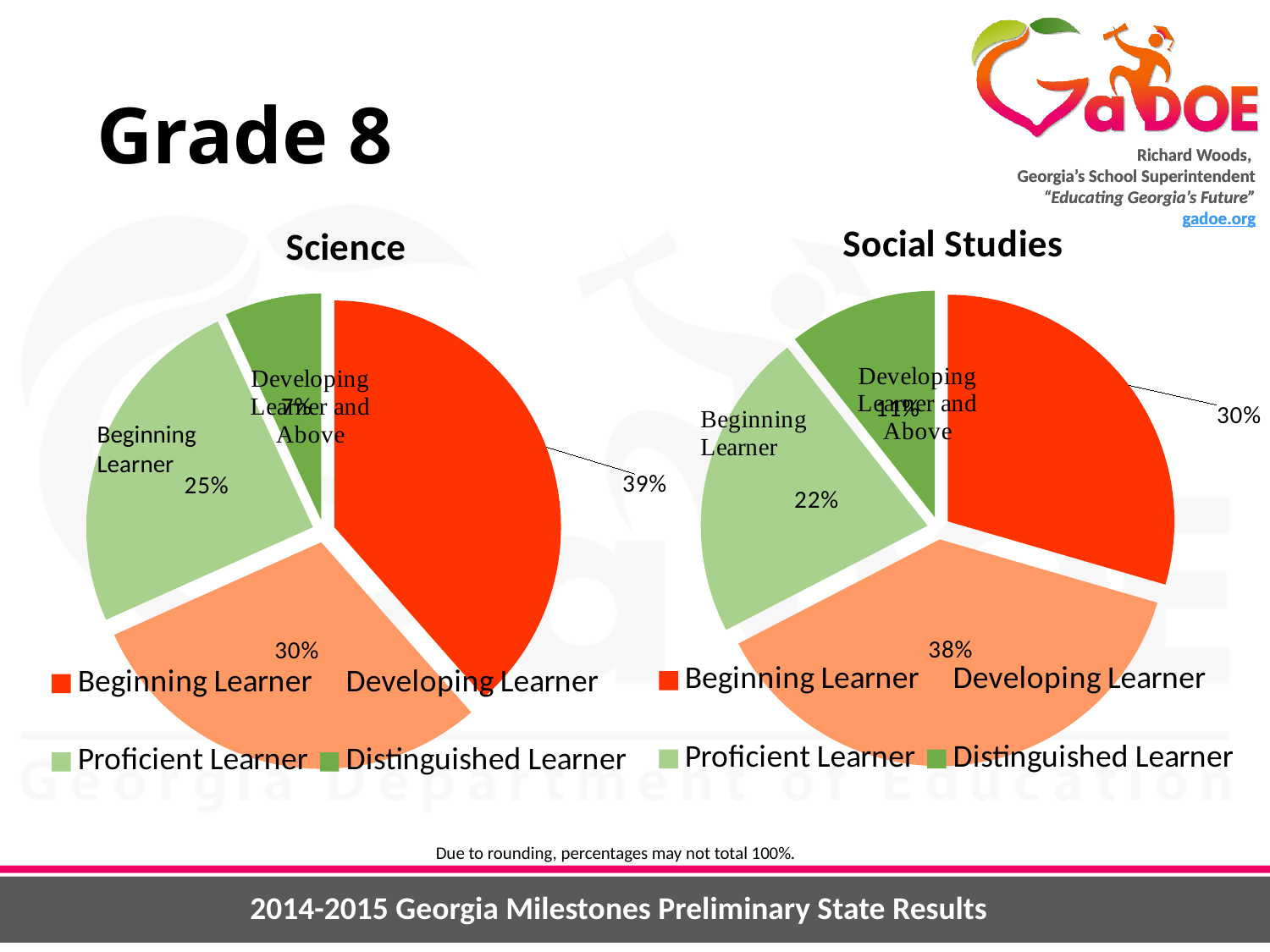
In the Science pie chart, which category has the largest share? Beginning Learner In the Science pie chart, what percentage is shown for Proficient Learner? 25% In the Science pie chart, what percentage is shown for Beginning Learner? 39% What type of chart is used for Science and Social Studies on this slide? Pie chart In the Social Studies pie chart, which category has the smallest share? Distinguished Learner In the Science pie chart, what percentage is shown for Developing Learner? 30% In the Social Studies pie chart, what percentage is shown for Distinguished Learner? 11% Which is larger in the Science pie chart: Proficient Learner or Developing Learner? Developing Learner In the Social Studies pie chart, what percentage is shown for Developing Learner? 38% In the Social Studies pie chart, what percentage is shown for Proficient Learner? 22% How many categories does the Social Studies pie chart show? 4 In the Social Studies pie chart, what is the difference between the Developing Learner and Beginning Learner percentages? 8%